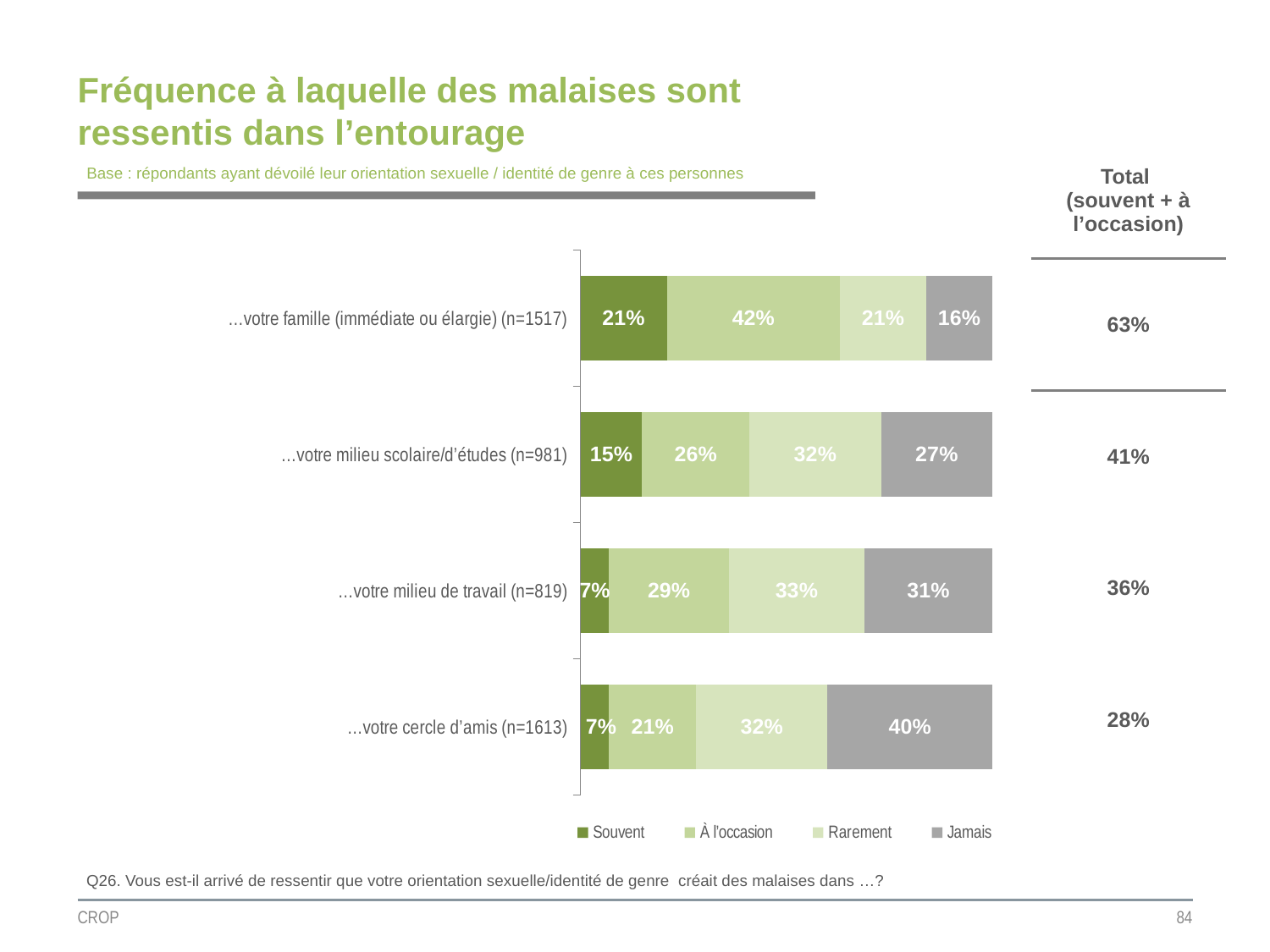
How many series does the legend list? 4 Which category has the highest "Jamais" value? …votre cercle d'amis What is the "Jamais" value for "…votre cercle d'amis"? 40% What is the "Total (souvent + à l'occasion)" value shown for "…votre milieu scolaire/d'études"? 41% What is the "À l'occasion" value for "…votre milieu scolaire/d'études"? 26% What is the "Rarement" value for "…votre milieu de travail"? 33% Which category has the highest "Souvent" value? …votre famille (immédiate ou élargie) What is the difference between the "Jamais" value for "…votre cercle d'amis" and the "Jamais" value for "…votre famille"? 24 percentage points What percentage of respondents answered "Souvent" for "…votre famille (immédiate ou élargie)"? 21% What kind of chart is shown on the slide? Stacked bar chart Which is larger: the "À l'occasion" value for "…votre famille" or for "…votre milieu de travail"? …votre famille How many categories are shown in the chart? 4